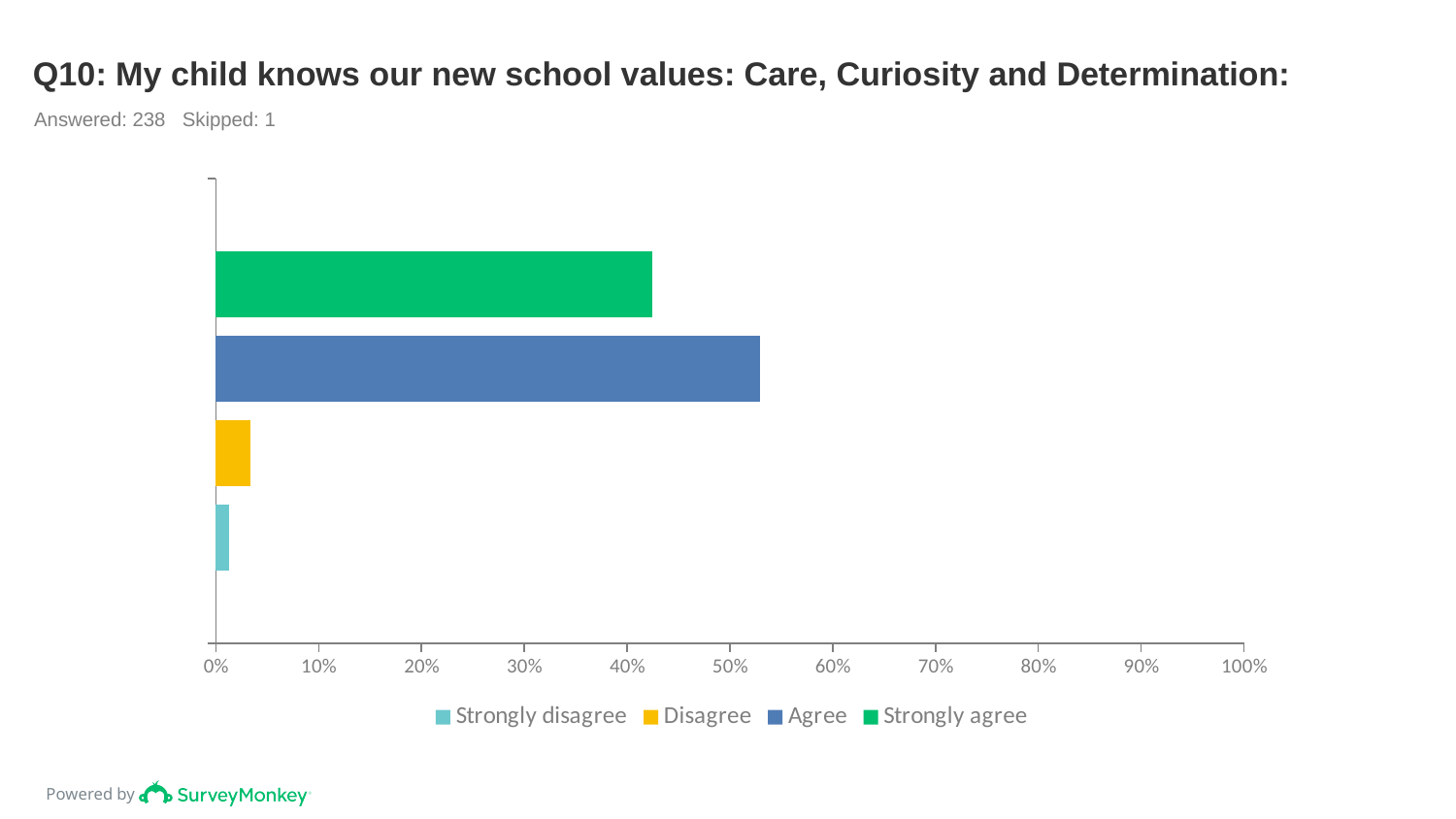
Is the value for Strongly agree greater or less than 50%? less Which response option is shown in yellow in the legend? Disagree How many respondents answered this question according to the slide? 238 Is the value for Disagree greater or less than 10%? less Which is larger, the value for Agree or the value for Strongly agree? Agree Which is larger, the value for Disagree or the value for Strongly disagree? Disagree What kind of chart is shown on the slide? Bar chart Which response option has the longest bar? Agree Is the value for Agree greater or less than 50%? greater How many series does the legend list? 4 Which response option has the shortest bar? Strongly disagree